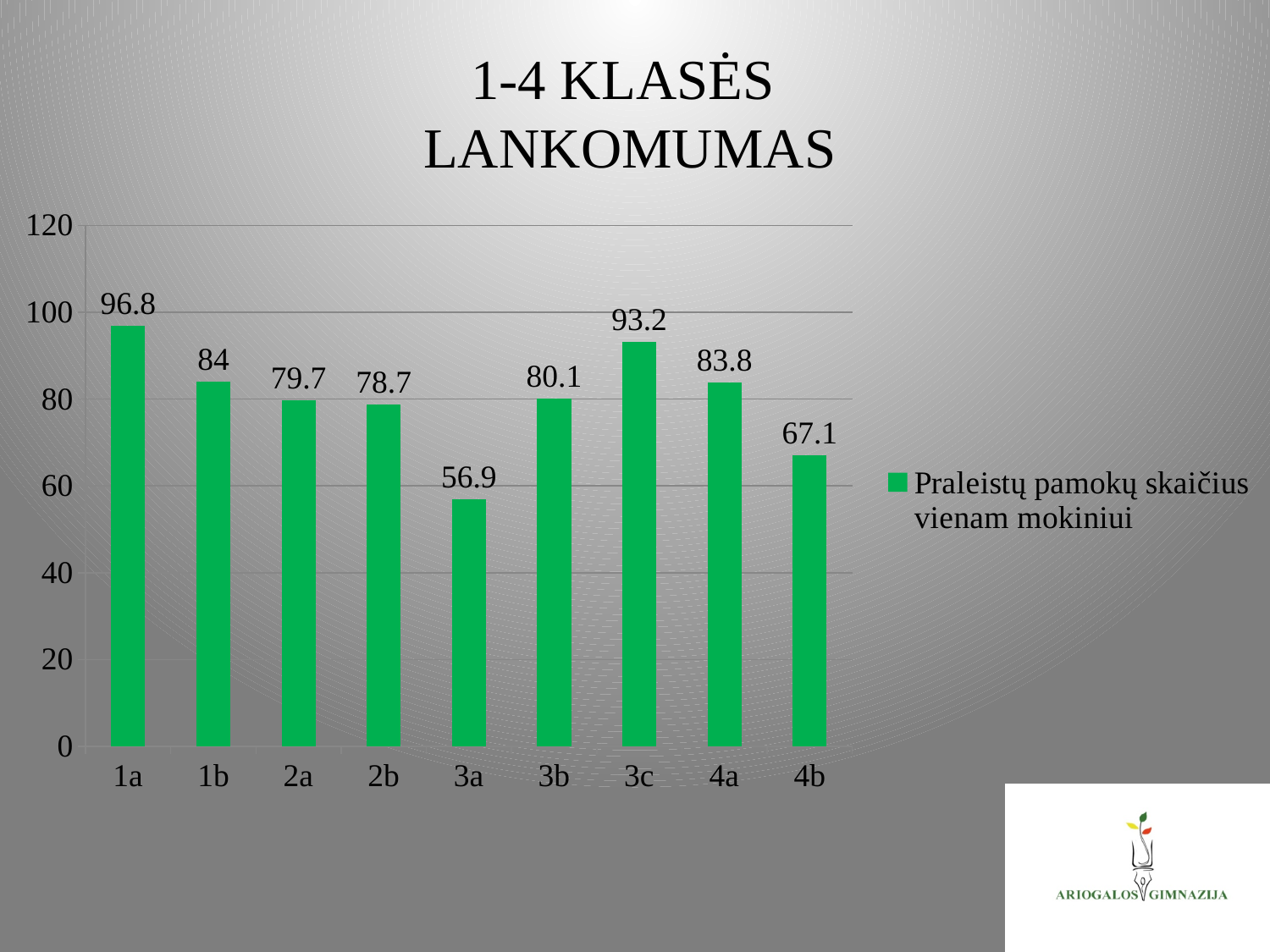
What is the value for class 3a? 56.9 What kind of chart is shown on the slide? bar chart What is the value for class 4b? 67.1 Which class has the lowest value? 3a How many classes are shown on the x axis? 9 What is the value for class 1a? 96.8 What is the legend entry for the series? Praleistų pamokų skaičius vienam mokiniui Which class has the highest value? 1a Is the value for 3c greater or less than 80? greater Which is larger, the value for 1b or the value for 2b? 1b What is the difference between the values for 1a and 3a? 39.9 What is the difference between the values for 3c and 4b? 26.1